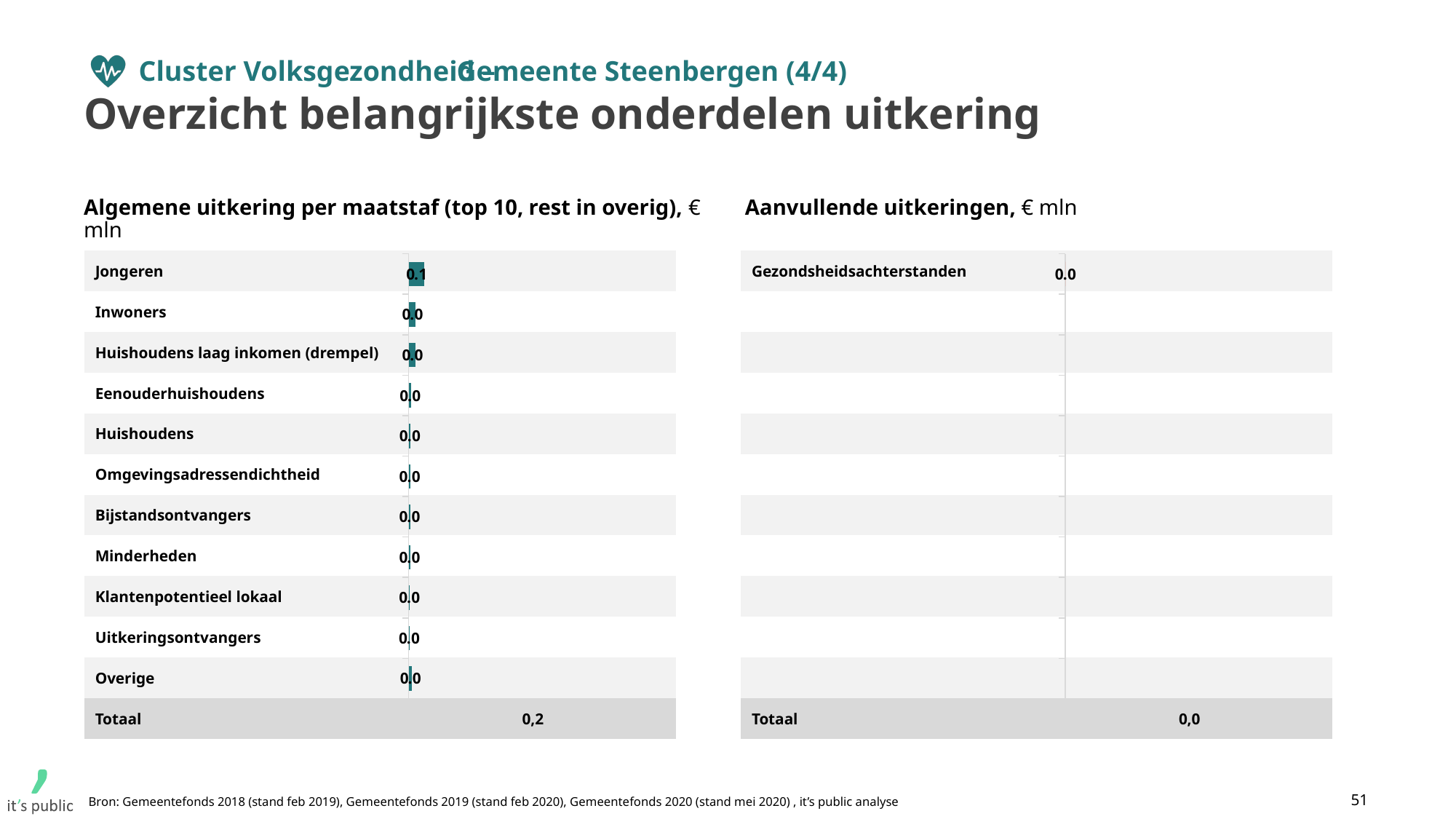
In the chart 'Aanvullende uitkeringen', what is the Totaal value? 0,0 In the chart 'Algemene uitkering per maatstaf (top 10, rest in overig)', which is larger: the value for Jongeren or the value for Overige? Jongeren In the chart 'Aanvullende uitkeringen', how many categories are shown (excluding the Totaal row)? 1 In the chart 'Algemene uitkering per maatstaf (top 10, rest in overig)', what is the Totaal value? 0,2 In the chart 'Algemene uitkering per maatstaf (top 10, rest in overig)', what is the difference between the value for Jongeren and the value for Inwoners? 0.1 What unit is stated in the title of the chart 'Aanvullende uitkeringen'? € mln In the chart 'Algemene uitkering per maatstaf (top 10, rest in overig)', what is the value for Inwoners? 0.0 In the chart 'Algemene uitkering per maatstaf (top 10, rest in overig)', how many categories are shown (excluding the Totaal row)? 11 What kind of chart is 'Algemene uitkering per maatstaf (top 10, rest in overig)'? Bar chart In the chart 'Algemene uitkering per maatstaf (top 10, rest in overig)', which category has the highest value? Jongeren In the chart 'Algemene uitkering per maatstaf (top 10, rest in overig)', what is the value for Jongeren? 0.1 In the chart 'Aanvullende uitkeringen', what is the value for Gezondsheidsachterstanden? 0.0